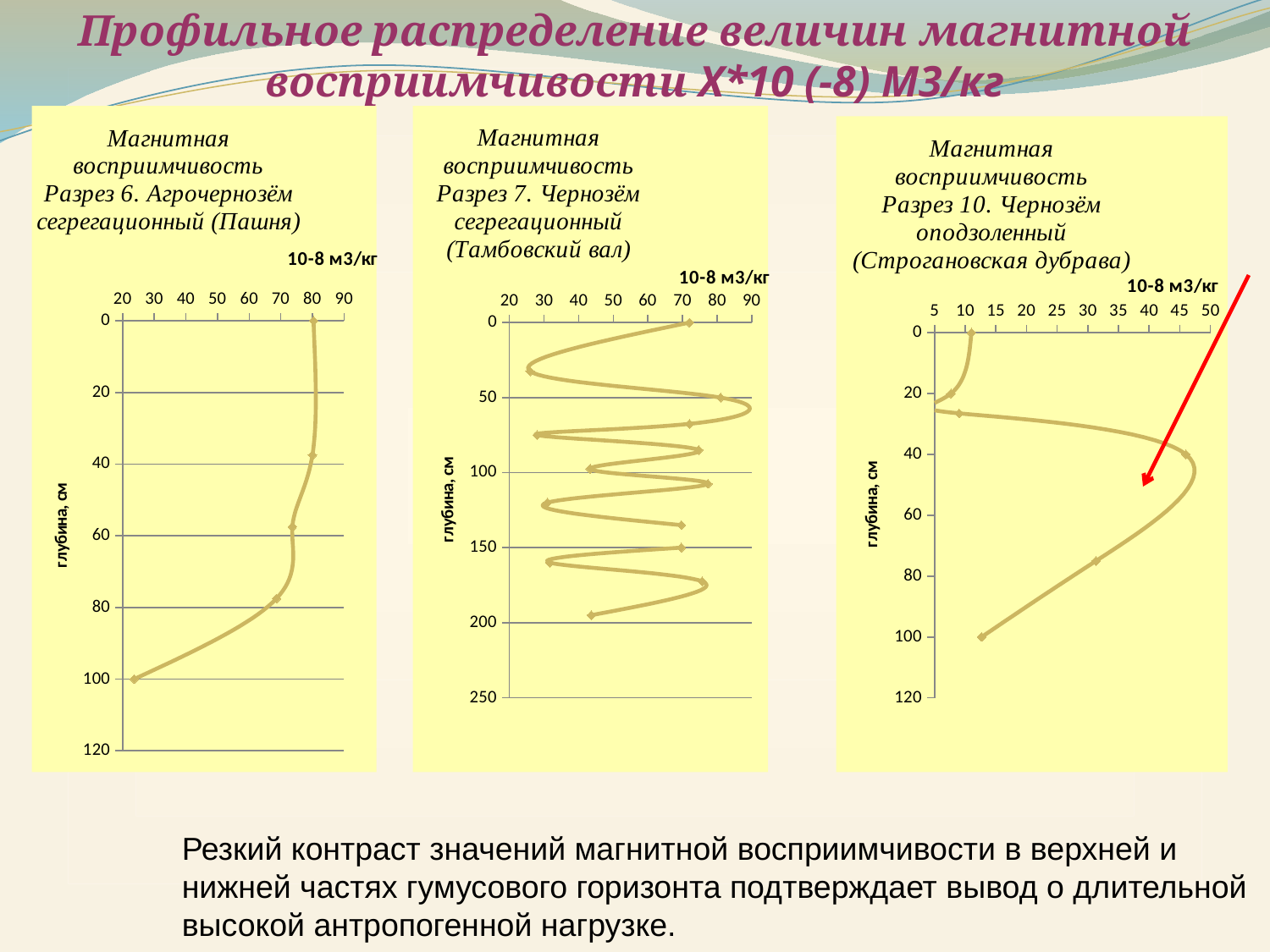
In the middle chart (Разрез 7. Чернозём сегрегационный), is the magnetic susceptibility at depth 0 cm greater or less than 60? greater In the right chart (Разрез 10. Чернозём оподзоленный), is the magnetic susceptibility at depth 40 cm greater or less than 40? greater What kind of chart is used for Разрез 6 (the left chart)? line chart What is the label of the vertical axis in the middle chart (Разрез 7)? глубина, см In the right chart (Разрез 10), which depth has the larger magnetic susceptibility, 40 cm or 100 cm? 40 cm In the left chart (Разрез 6), is the magnetic susceptibility at depth 100 cm greater or less than 30? less In the left chart (Разрез 6), does the magnetic susceptibility increase or decrease as depth increases from 0 to 100 cm? decrease In the left chart (Разрез 6), which depth has the larger magnetic susceptibility, 0 cm or 100 cm? 0 cm How many data points are plotted in the left chart (Разрез 6)? 5